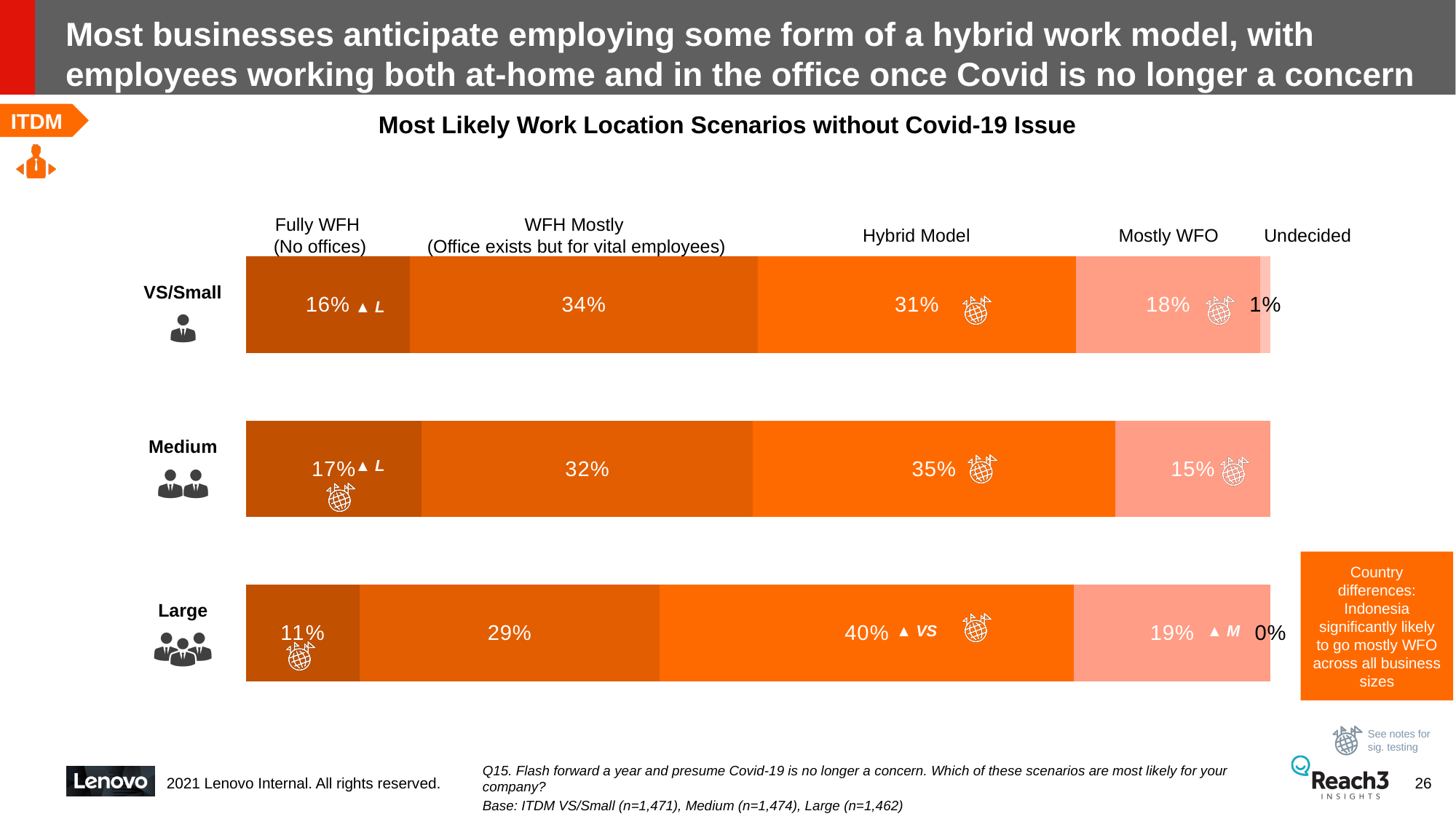
Which business size has the highest share expecting a Hybrid Model? Large Which is larger: the Mostly WFO share for Large businesses or for Medium businesses? Large What is the title of the chart? Most Likely Work Location Scenarios without Covid-19 Issue What percentage of Large businesses expect a Hybrid Model? 40% What is the difference between the Hybrid Model share for Large businesses and for VS/Small businesses? 9 percentage points Which business size has the lowest share expecting to be Fully WFH? Large How many business size categories are plotted in the chart? 3 What percentage of Medium businesses expect to be Fully WFH? 17% What kind of chart is shown on the slide? Stacked bar chart What percentage of VS/Small businesses expect WFH Mostly? 34% What percentage of VS/Small businesses are Undecided? 1% How many work location scenarios (series) are shown across the top of the chart? 5